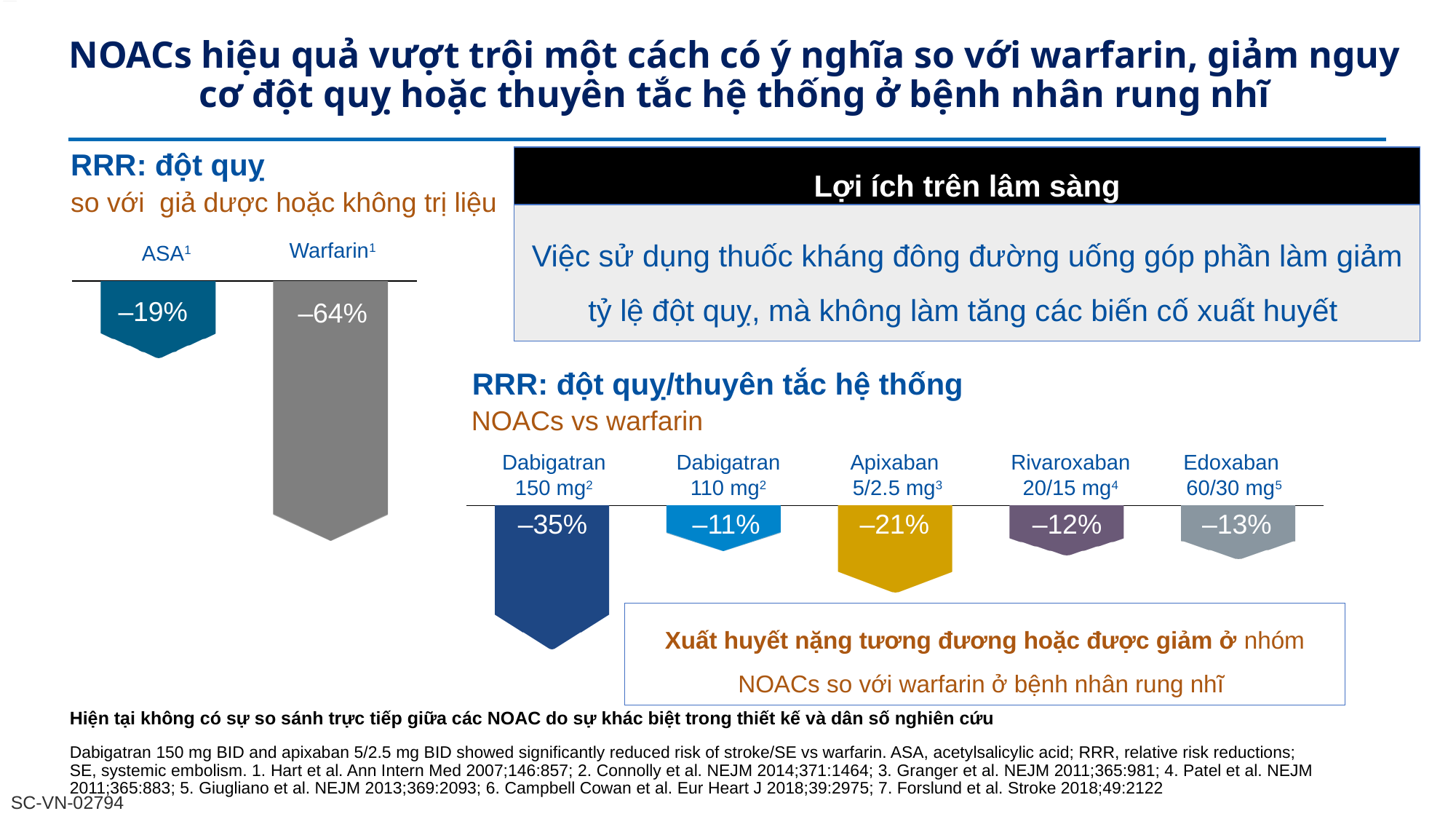
In the 'RRR: đột quỵ/thuyên tắc hệ thống' chart, which drug shows the largest relative risk reduction? Dabigatran 150 mg In the 'RRR: đột quỵ/thuyên tắc hệ thống' chart, what is the difference in percentage points between the values for Dabigatran 150 mg and Dabigatran 110 mg? 24 percentage points In the 'RRR: đột quỵ/thuyên tắc hệ thống' chart, what is the value shown for Dabigatran 150 mg? –35% In the 'RRR: đột quỵ/thuyên tắc hệ thống' chart, what is the value shown for Rivaroxaban 20/15 mg? –12% In the 'RRR: đột quỵ/thuyên tắc hệ thống' chart, which drug shows the smallest relative risk reduction? Dabigatran 110 mg In the 'RRR: đột quỵ' chart on the left, which has the larger relative risk reduction, ASA or Warfarin? Warfarin In the 'RRR: đột quỵ' chart on the left, how many categories are shown? 2 In the 'RRR: đột quỵ/thuyên tắc hệ thống' chart, how many drug categories are shown? 5 In the 'RRR: đột quỵ/thuyên tắc hệ thống' chart, what is the value shown for Apixaban 5/2.5 mg? –21% In the 'RRR: đột quỵ' chart on the left, what is the value shown for Warfarin? –64% In the 'RRR: đột quỵ/thuyên tắc hệ thống' chart, what is the value shown for Edoxaban 60/30 mg? –13% In the 'RRR: đột quỵ' chart on the left, what is the value shown for ASA? –19%